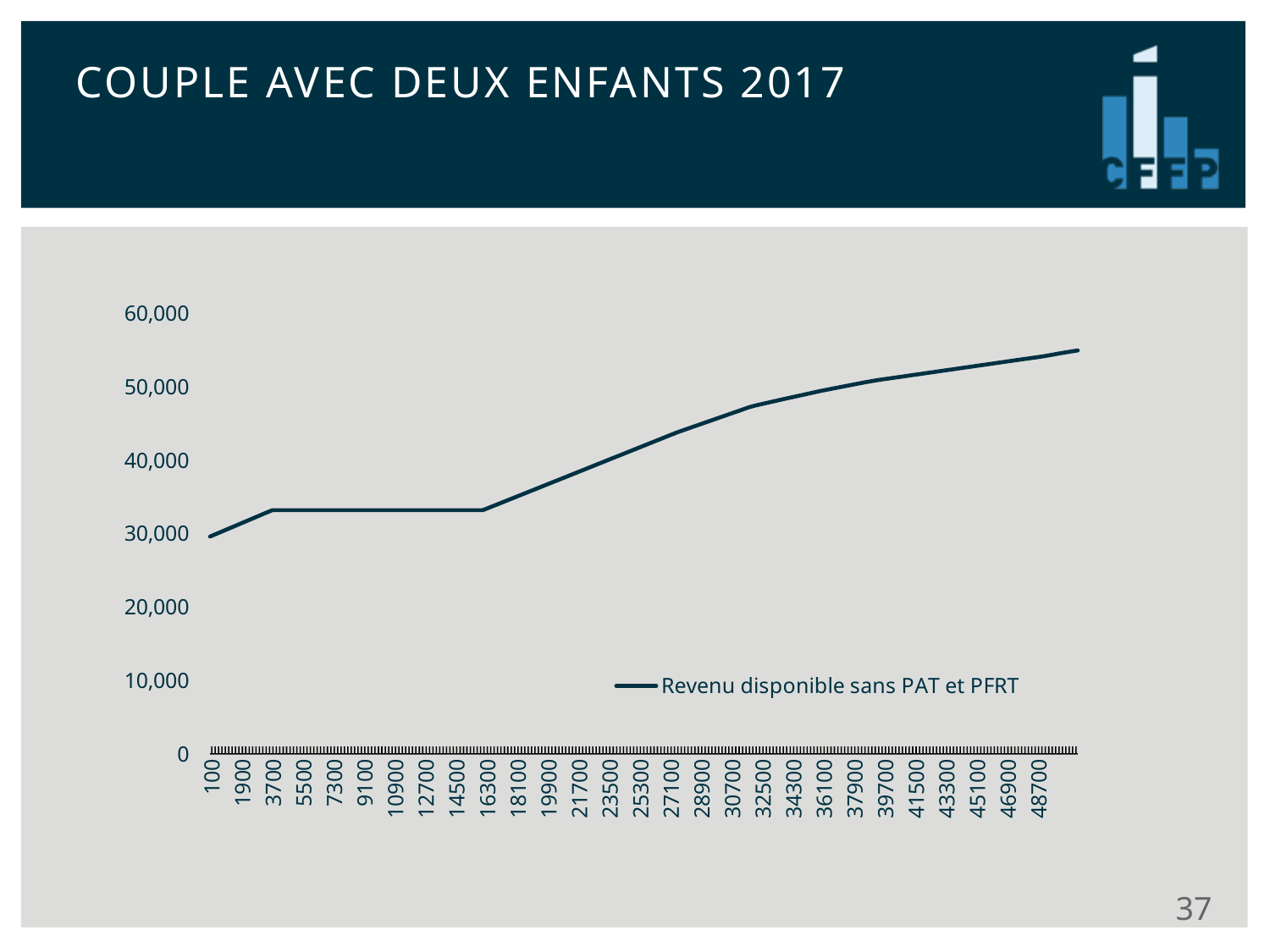
Do the values of the line generally rise or fall as you move from left to right along the x axis? rise What kind of chart is shown on the slide? line chart Is the value for 32500 greater or less than 50,000? less What is the name of the series shown in the legend? Revenu disponible sans PAT et PFRT How many series does the legend list? 1 Is the value for 16300 greater or less than 40,000? less Is the value for 3700 greater or less than 30,000? greater Which is larger, the value for 3700 or the value for 32500? 32500